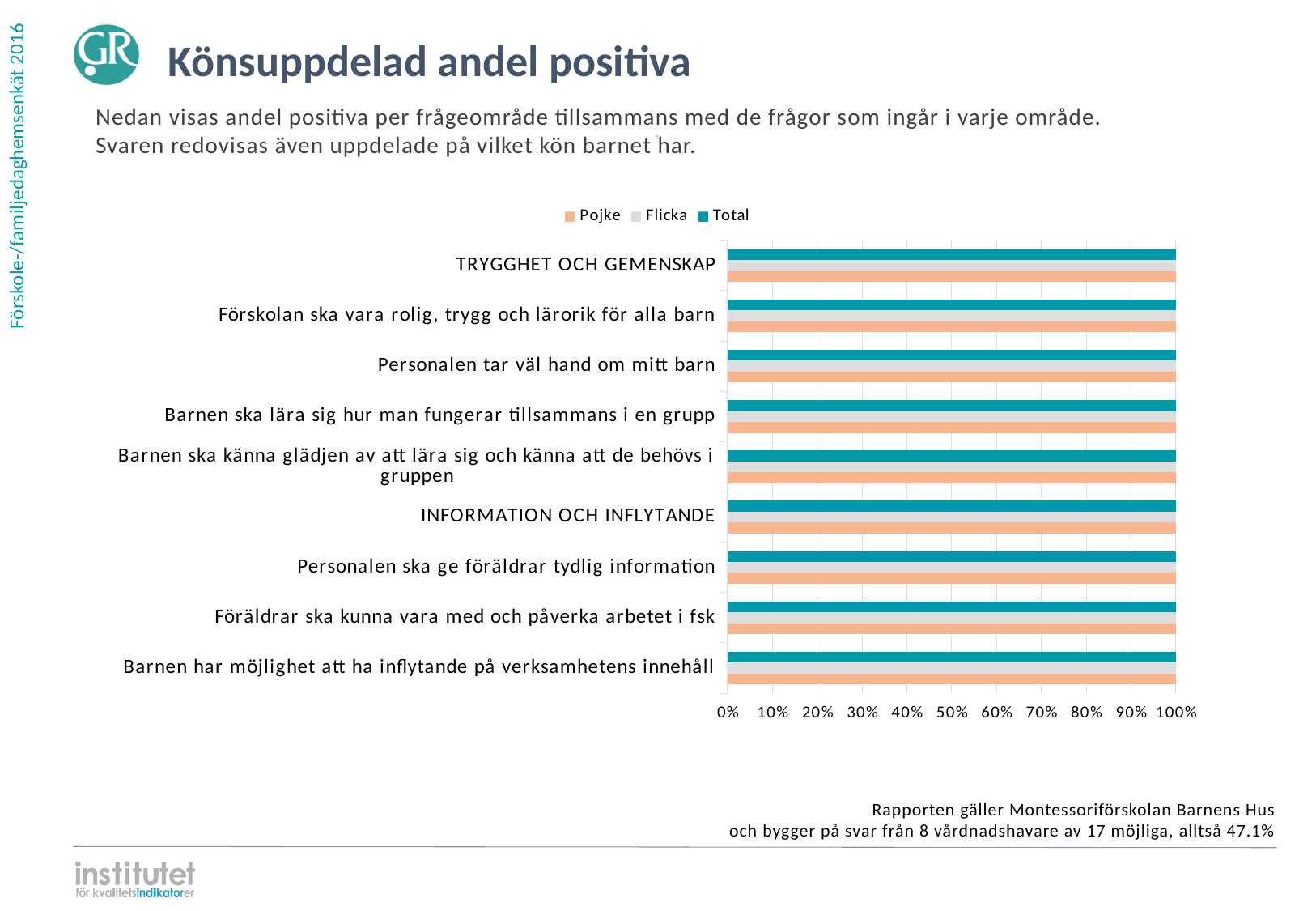
What is the highest value shown on the horizontal axis of the chart? 100% How many categories are shown on the vertical axis of the chart? 9 How many series does the legend list? 3 Is the Total value for TRYGGHET OCH GEMENSKAP greater or less than 90%? greater Which series are listed in the legend? Pojke, Flicka, Total Is the Pojke value for INFORMATION OCH INFLYTANDE greater or less than 50%? greater What is the title of the slide containing the chart? Könsuppdelad andel positiva Is the Flicka value for 'Personalen tar väl hand om mitt barn' greater or less than 80%? greater What is the Pojke value for 'Förskolan ska vara rolig, trygg och lärorik för alla barn'? 100% What is the Total value for 'Föräldrar ska kunna vara med och påverka arbetet i fsk'? 100% What kind of chart is shown on the slide? bar chart